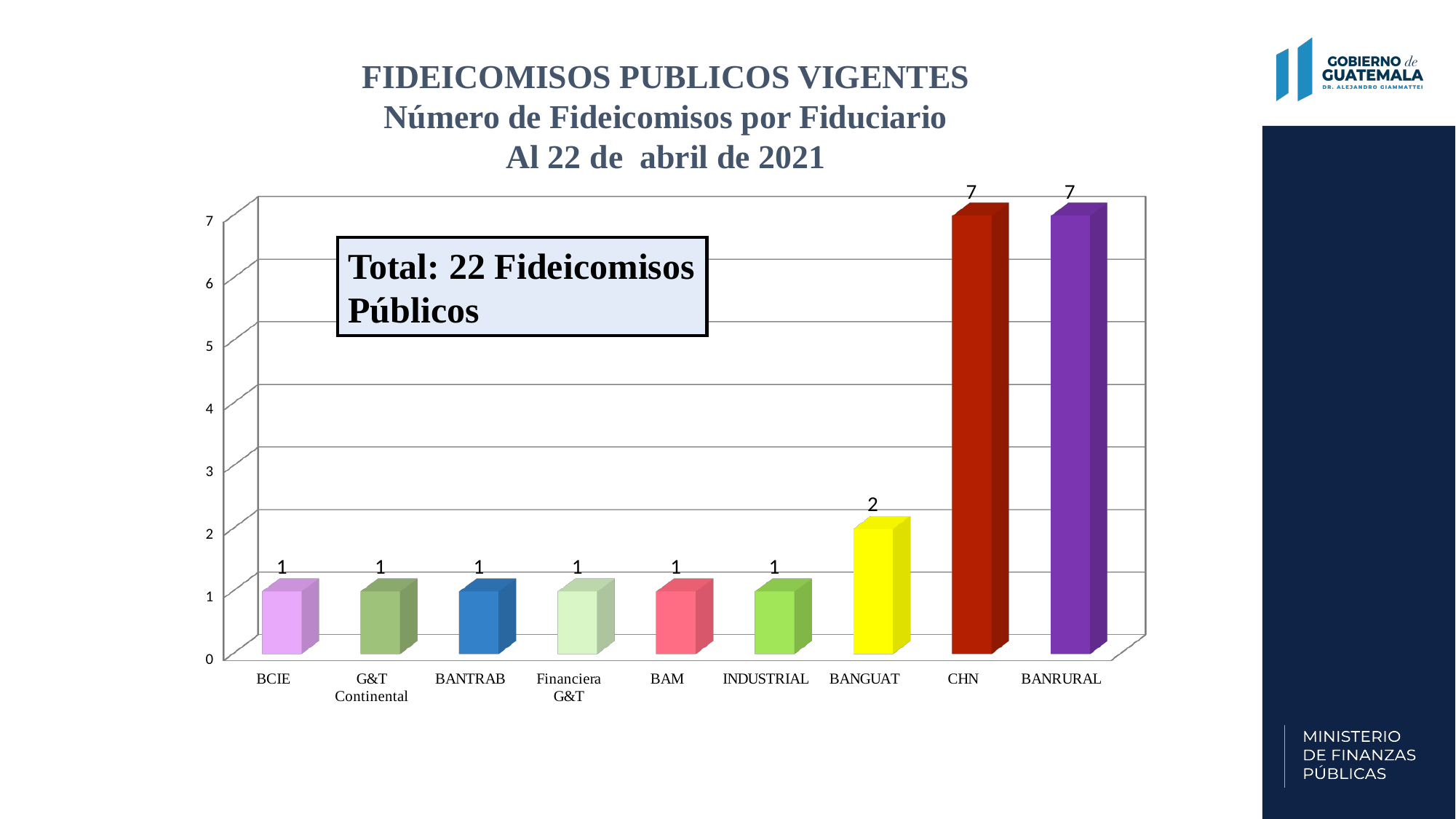
Which category has the lowest value among BANGUAT, CHN and BANRURAL? BANGUAT What is the value for INDUSTRIAL? 1 What is the difference between the values for BANGUAT and BAM? 1 Is the value for CHN greater or less than 5? greater Which is larger, the value for BANRURAL or the value for BANTRAB? BANRURAL What is the value for BANGUAT? 2 What kind of chart is shown on the slide? bar chart What is the difference between the values for CHN and BANGUAT? 5 What is the value for BCIE? 1 How many categories are shown on the x axis? 9 What is the value for CHN? 7 What total number of fideicomisos públicos is stated in the text box on the chart? 22